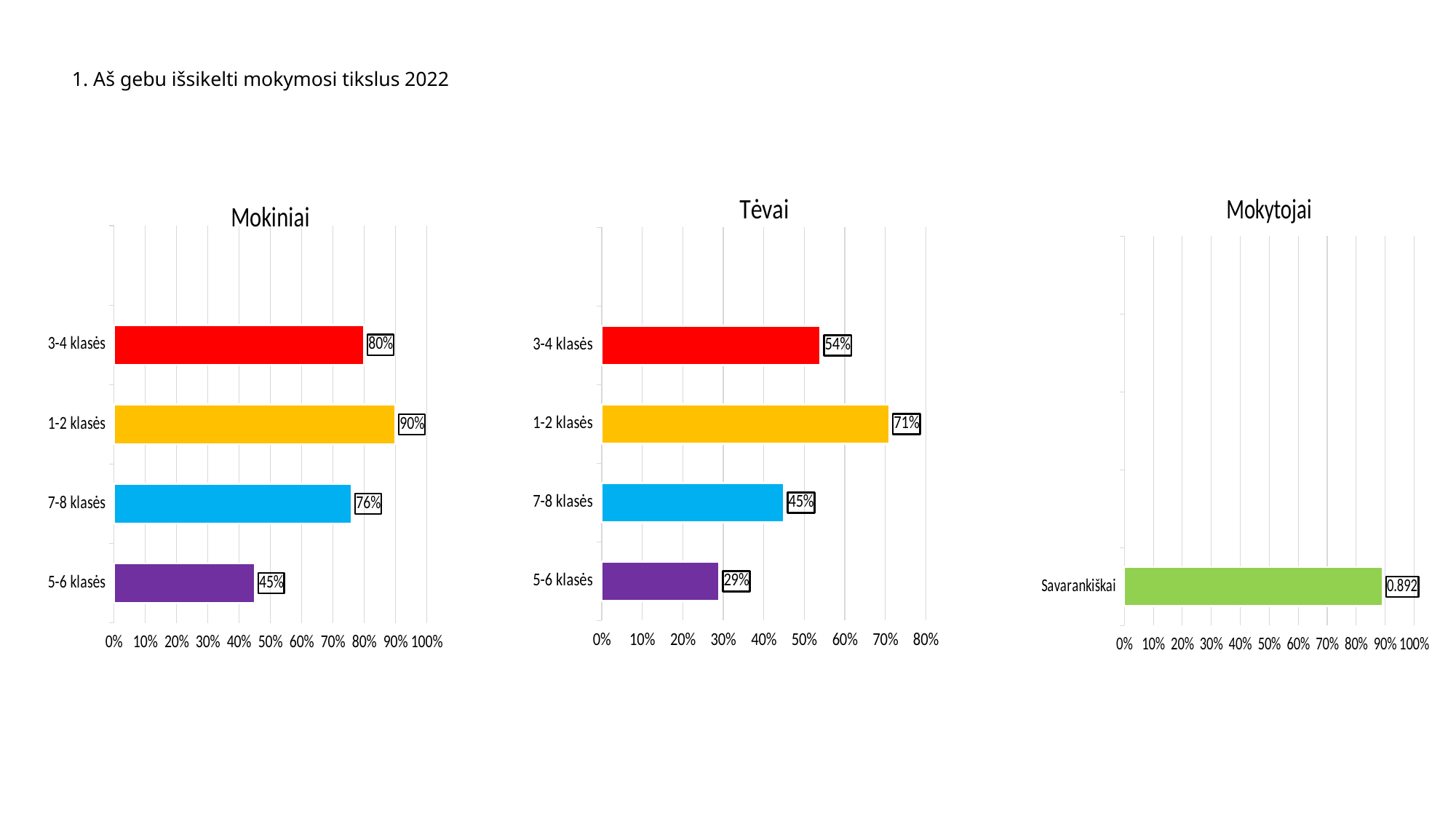
In the Mokytojai chart, what is the value for Savarankiškai? 0.892 In the Mokiniai chart, what is the value for 1-2 klasės? 90% In the Tėvai chart, what is the difference between the values for 1-2 klasės and 5-6 klasės? 42% In the Tėvai chart, which is larger, the value for 3-4 klasės or the value for 7-8 klasės? 3-4 klasės What is the title of the chart on the right of the slide? Mokytojai In the Mokiniai chart, is the value for 5-6 klasės greater or less than 50%? less In the Tėvai chart, what is the value for 7-8 klasės? 45% What kind of chart is the Mokiniai chart? bar chart In the Tėvai chart, which category has the highest value? 1-2 klasės How many categories does the Tėvai chart show? 4 In the Mokiniai chart, which category has the lowest value? 5-6 klasės In the Mokiniai chart, what is the difference between the values for 3-4 klasės and 7-8 klasės? 4%